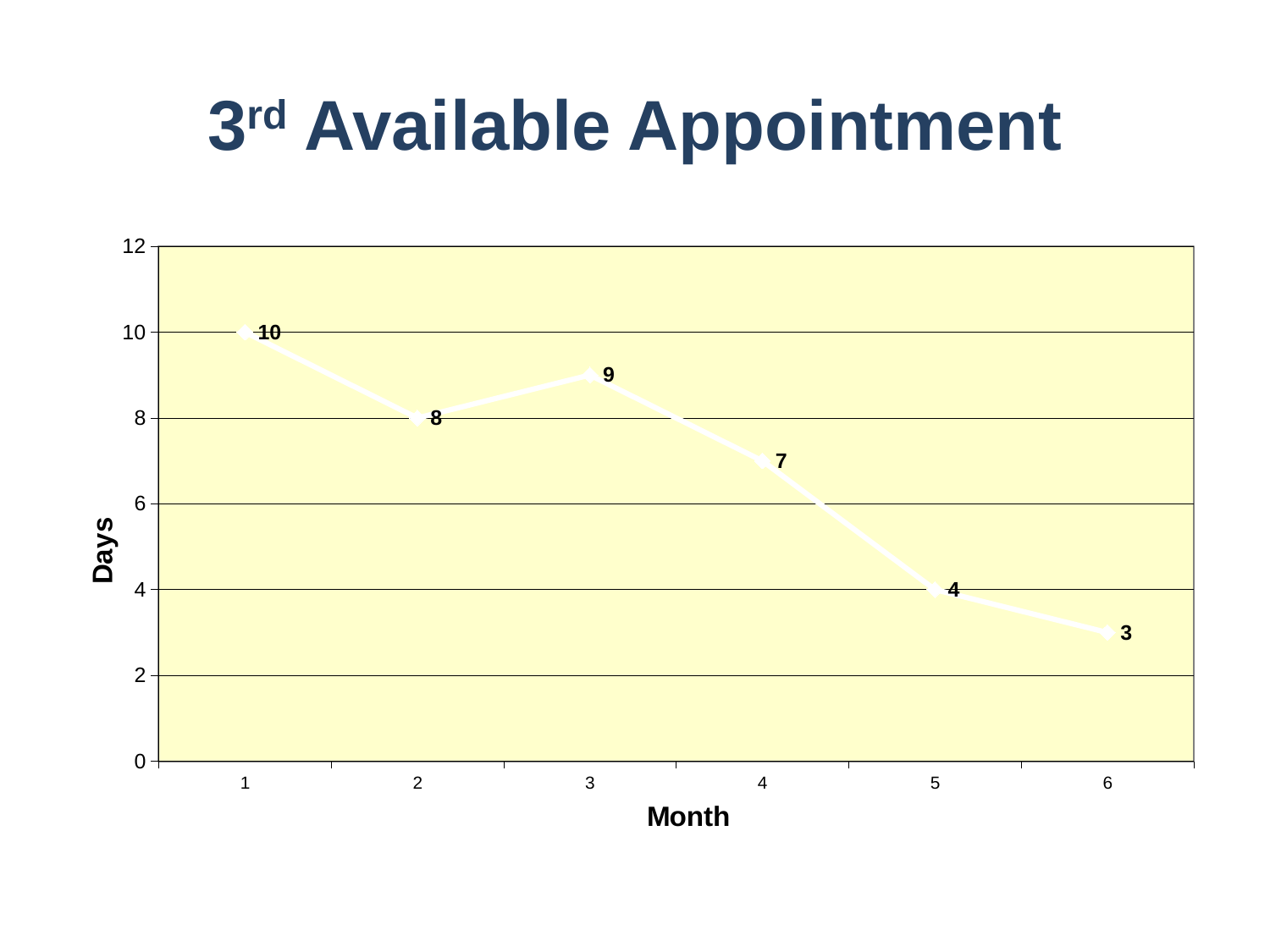
What is the value for month 3? 9 What is the difference between the values for month 3 and month 4? 2 What is the value for month 5? 4 What kind of chart is shown on the slide? line chart Which month has the highest value? 1 How many months are plotted on the chart? 6 What is the value for month 1? 10 Which is larger, the value for month 2 or the value for month 3? month 3 Which month has the lowest value? 6 What is the value for month 6? 3 Do the values generally rise or fall from month 1 to month 6? fall What is the difference between the values for month 1 and month 6? 7